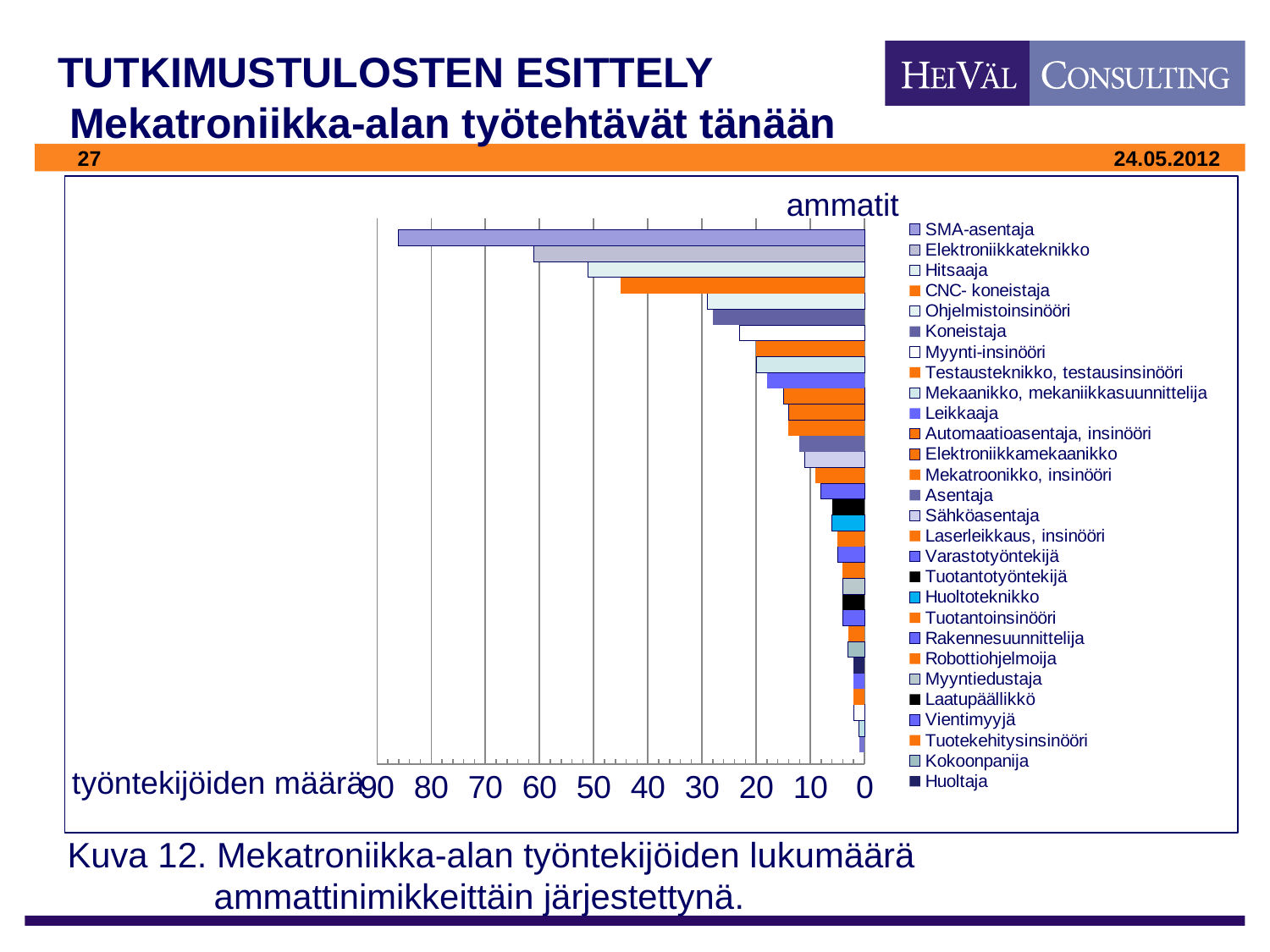
Which is larger, the value for SMA-asentaja or the value for Hitsaaja? SMA-asentaja Is the value for Hitsaaja greater or less than 60? less Is the value for Koneistaja greater or less than 20? greater Is the value for Elektroniikkateknikko greater or less than 70? less Which is larger, the value for Elektroniikkateknikko or the value for CNC- koneistaja? Elektroniikkateknikko How many entries does the legend list? 28 What is the title shown above the legend of the chart? ammatit Which occupation has the highest number of employees in the chart? SMA-asentaja What kind of chart is shown on the slide? bar chart